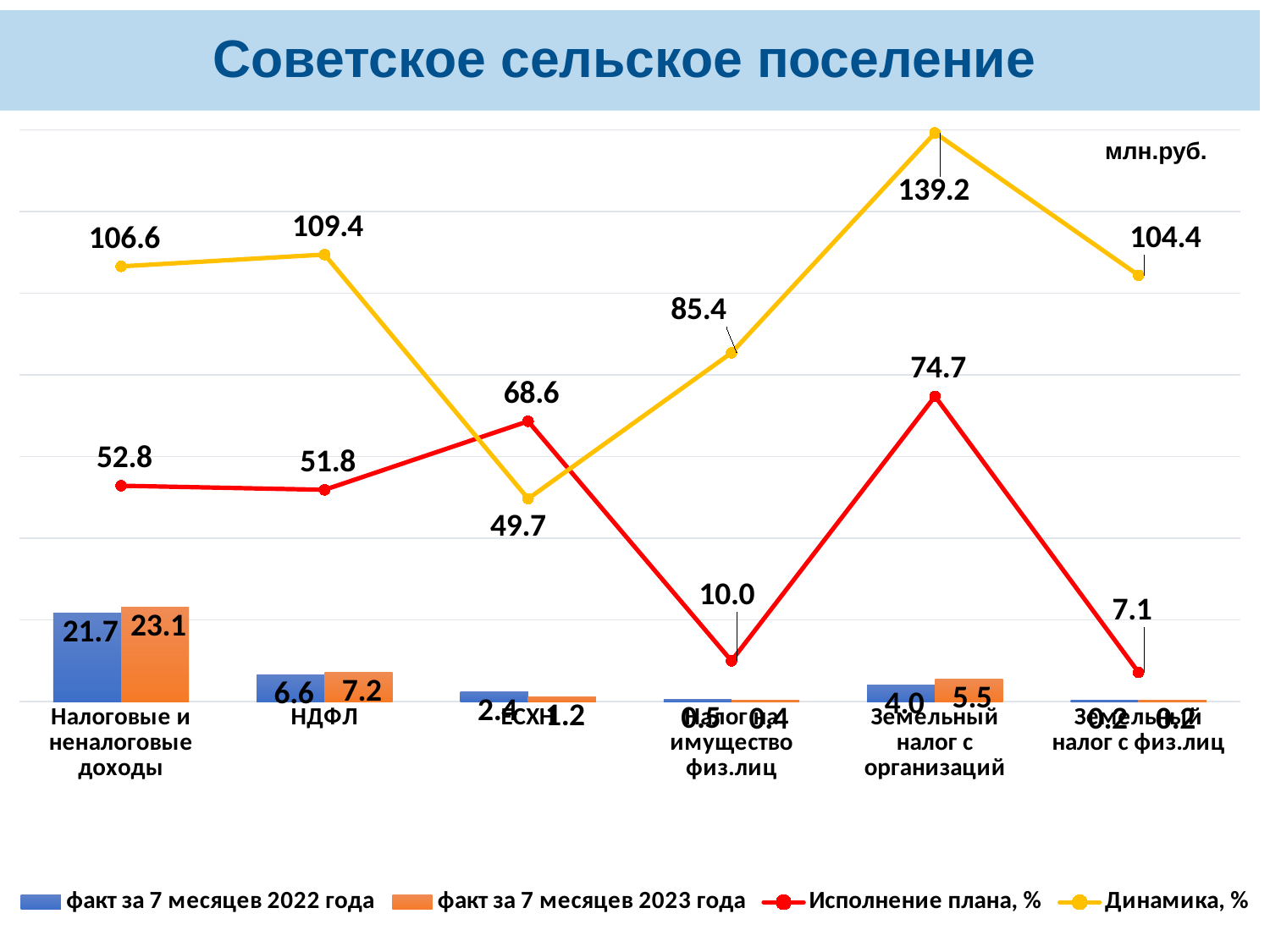
What is the value of 'Динамика, %' for Земельный налог с организаций? 139.2 How many categories are shown on the x axis? 6 What is the title of the slide? Советское сельское поселение What kind of chart is shown on the slide? Combined bar and line chart What is the value of 'факт за 7 месяцев 2022 года' for НДФЛ? 6.6 How many series does the legend list? 4 Which category has the highest value of 'Динамика, %'? Земельный налог с организаций What is the difference between 'факт за 7 месяцев 2023 года' and 'факт за 7 месяцев 2022 года' for Земельный налог с организаций? 1.5 What is the value of 'Исполнение плана, %' for ЕСХН? 68.6 Which is larger for ЕСХН: 'факт за 7 месяцев 2022 года' or 'факт за 7 месяцев 2023 года'? факт за 7 месяцев 2022 года What is the value of 'факт за 7 месяцев 2023 года' for Налоговые и неналоговые доходы? 23.1 Which category has the lowest value of 'Исполнение плана, %'? Земельный налог с физ.лиц